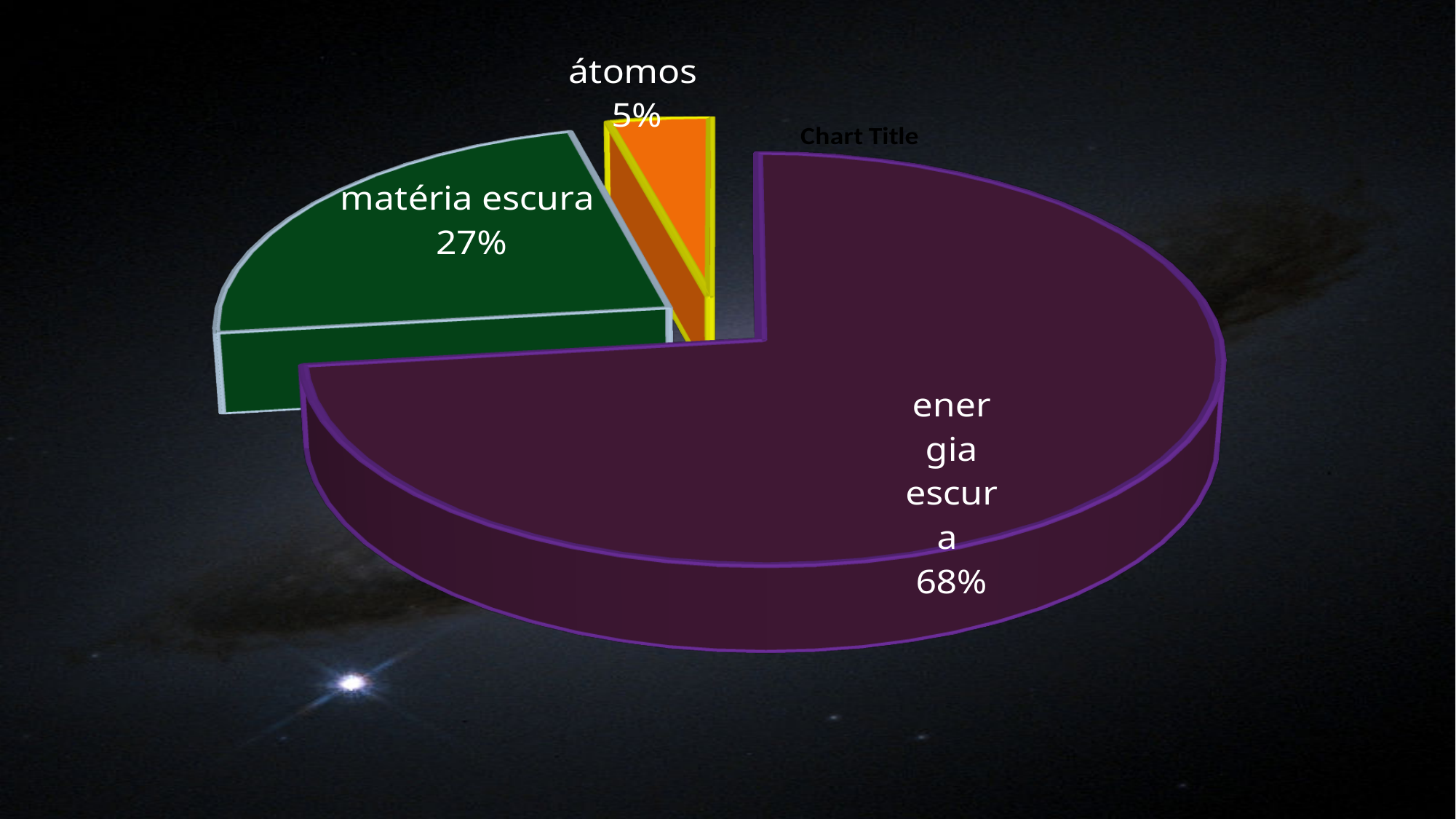
What is the difference in percentage points between 'energia escura' and 'matéria escura'? 41 What is the title shown on the chart? Chart Title Which slice is the smallest? átomos What kind of chart is shown on the slide? pie chart Which slice is the largest? energia escura What percentage does the 'átomos' slice represent? 5% Which is larger, the 'matéria escura' slice or the 'átomos' slice? matéria escura What percentage does the 'matéria escura' slice represent? 27% How many slices does the pie chart have? 3 What percentage does the 'energia escura' slice represent? 68% What colour is the 'matéria escura' slice? green What is the difference in percentage points between 'matéria escura' and 'átomos'? 22